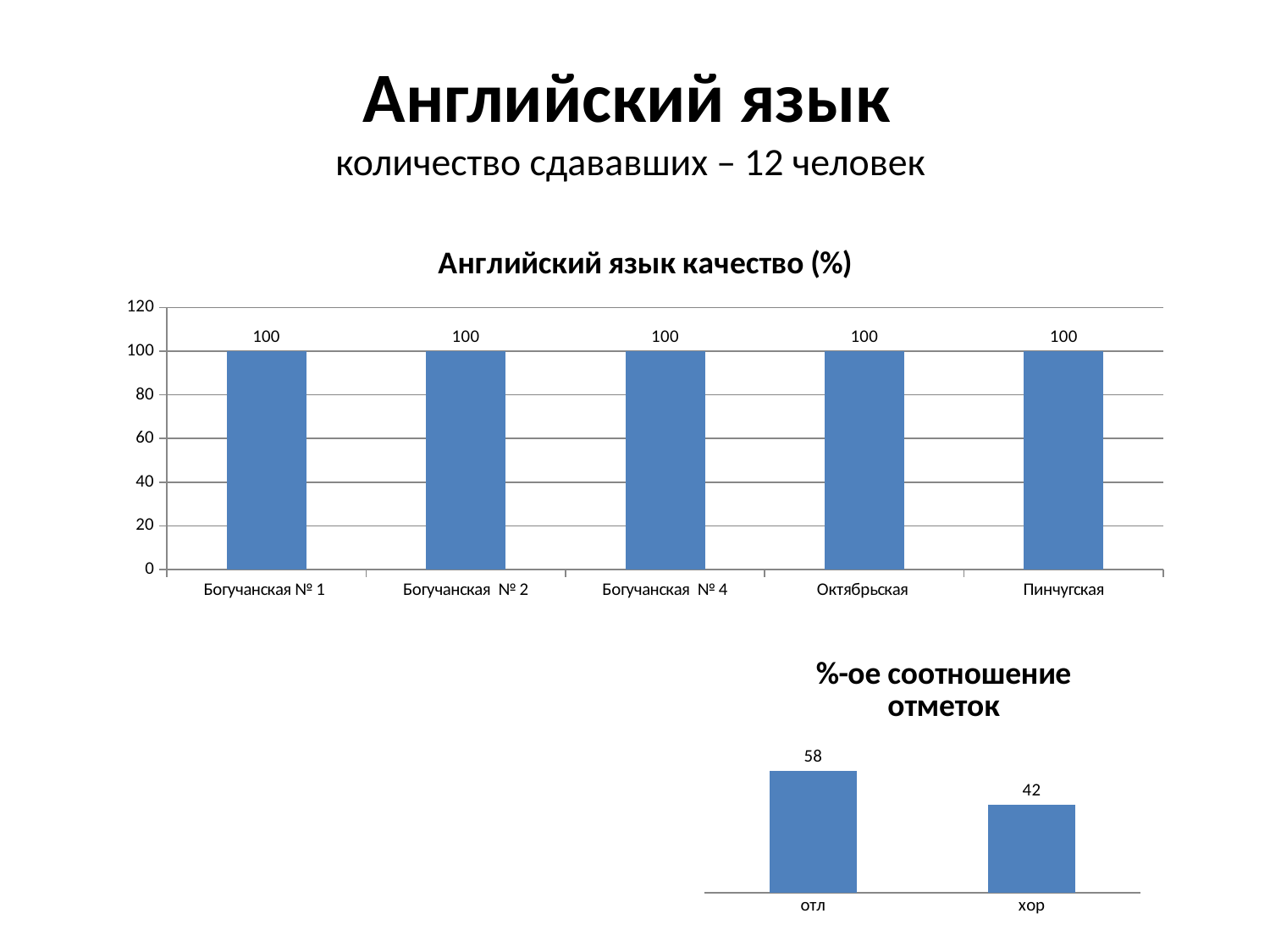
In the chart titled "Английский язык качество (%)", is the value for Богучанская № 1 greater or less than 80? greater In the chart titled "%-ое соотношение отметок", which category has the lowest value? хор In the chart titled "%-ое соотношение отметок", how many categories are shown? 2 In the chart titled "%-ое соотношение отметок", what is the difference between the values for отл and хор? 16 In the chart titled "Английский язык качество (%)", what is the value for Пинчугская? 100 In the chart titled "Английский язык качество (%)", what is the value for Октябрьская? 100 In the chart titled "Английский язык качество (%)", what is the difference between the values for Богучанская № 2 and Богучанская № 4? 0 In the chart titled "Английский язык качество (%)", how many categories are shown on the x axis? 5 In the chart titled "%-ое соотношение отметок", what is the value for отл? 58 What kind of chart is the one titled "Английский язык качество (%)"? bar chart In the chart titled "%-ое соотношение отметок", which category has the highest value? отл In the chart titled "%-ое соотношение отметок", what is the value for хор? 42